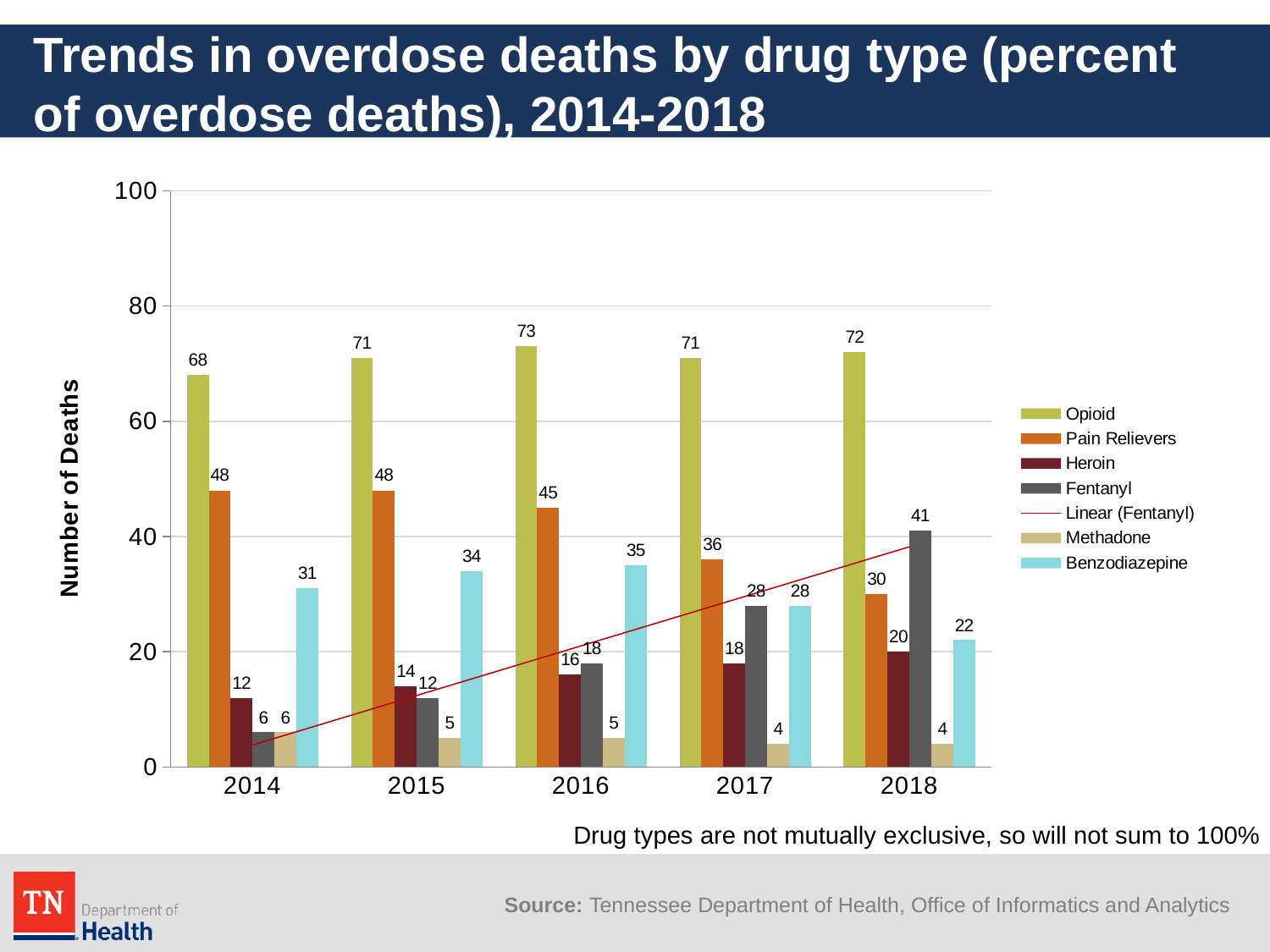
How many entries does the legend list? 7 What is the value for Benzodiazepine in 2014? 31 Is the value for Benzodiazepine in 2015 greater or less than 40? less What kind of chart is shown on the slide? bar chart What is the value for Opioid in 2016? 73 In 2016, which is larger: Heroin or Fentanyl? Fentanyl What is the value for Fentanyl in 2018? 41 Do the Heroin values rise or fall from 2014 to 2018? rise In which year is the Opioid value highest? 2016 In which year is the Pain Relievers value lowest? 2018 What is the difference between the Fentanyl value in 2018 and in 2014? 35 How many years are shown on the x axis? 5